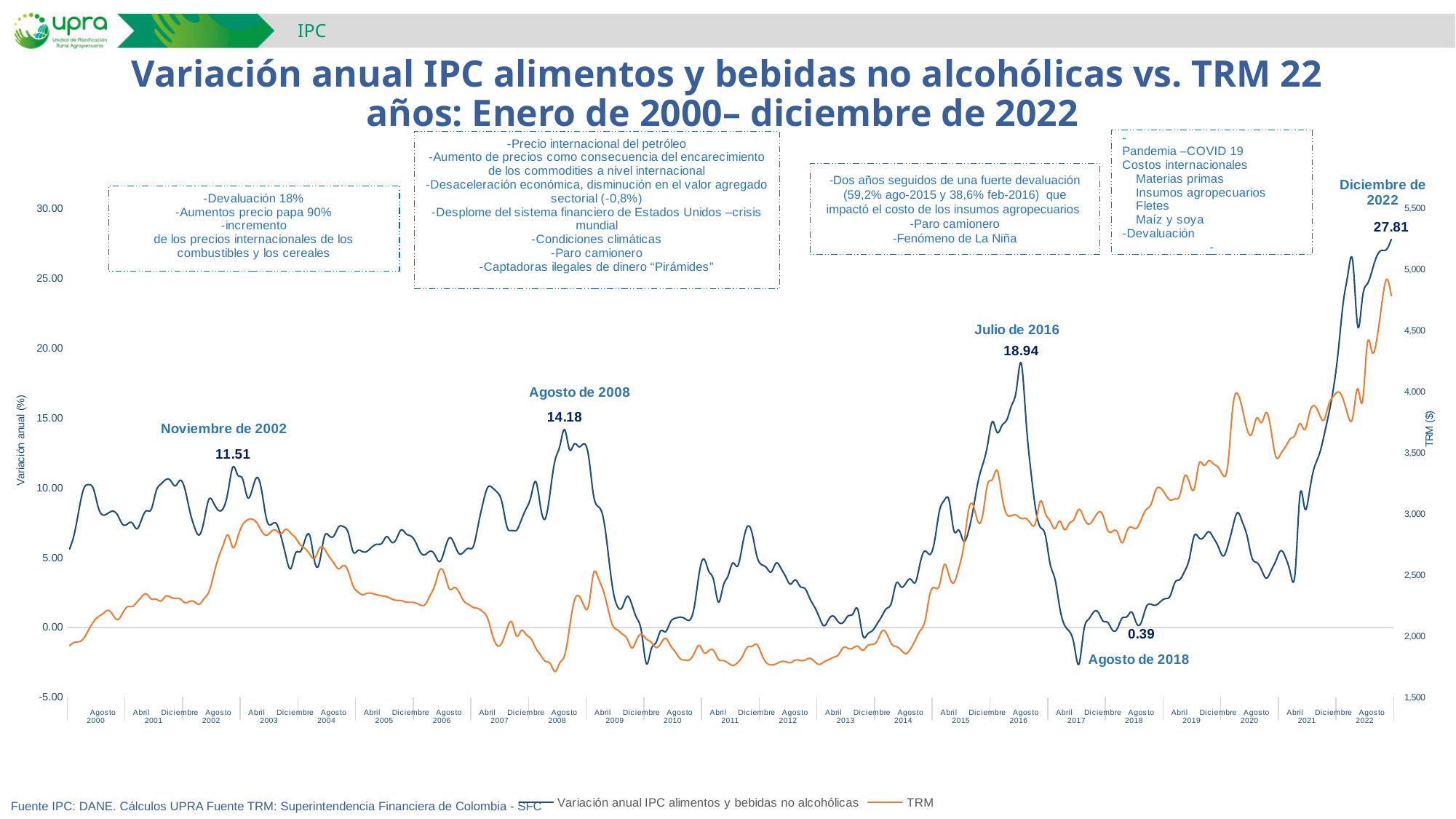
What is the labelled value of the annual IPC variation for Julio de 2016? 18.94 What is the labelled value of the annual IPC variation for Agosto de 2018? 0.39 What type of chart is shown on the slide? line chart Which series is drawn in orange? TRM Which labelled point has the lowest annual IPC variation? Agosto de 2018 What is the labelled value of the annual IPC variation for Diciembre de 2022? 27.81 Which labelled point has the highest annual IPC variation? Diciembre de 2022 What is the labelled value of the annual IPC variation for Agosto de 2008? 14.18 What is the labelled value of the annual IPC variation for Noviembre de 2002? 11.51 Which labelled IPC value is larger, Agosto de 2008 or Noviembre de 2002? Agosto de 2008 What is the difference between the labelled IPC values for Diciembre de 2022 and Julio de 2016? 8.87 How many series does the legend list? 2